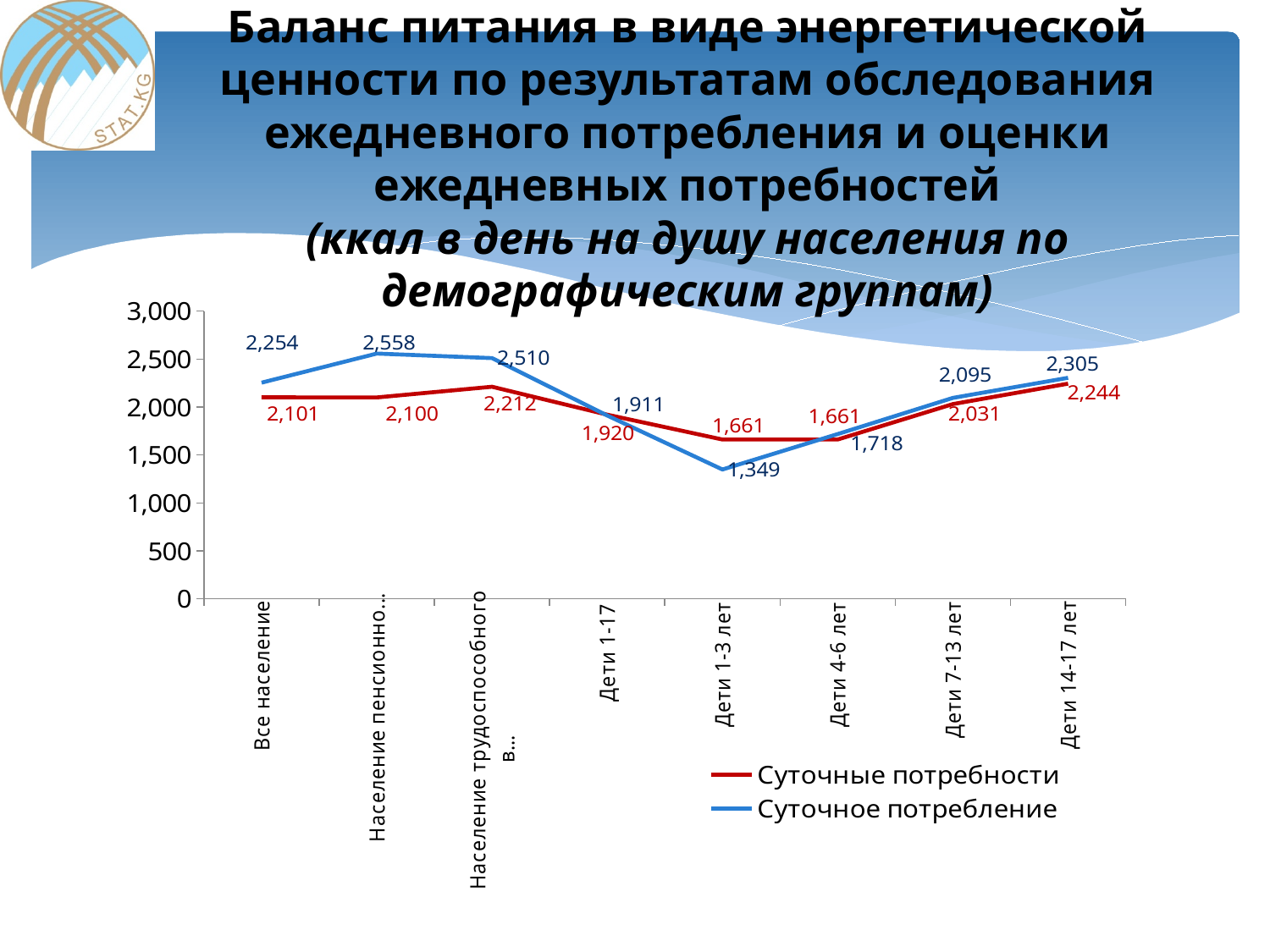
What is the difference between Суточное потребление and Суточные потребности for Дети 4-6 лет? 57 Which category has the lowest value for Суточное потребление? Дети 1-3 лет For Дети 7-13 лет, which is larger: Суточные потребности or Суточное потребление? Суточное потребление How many categories are shown on the x axis of the chart? 8 What is the difference between Суточные потребности and Суточное потребление for Дети 1-3 лет? 312 What kind of chart is shown on the slide? line chart How many series does the legend list? 2 What is the value of Суточное потребление for Дети 1-3 лет? 1,349 What is the value of Суточное потребление for Все население? 2,254 Is the value of Суточное потребление for Дети 1-3 лет greater or less than 1,500? less Which category has the highest value for Суточные потребности? Дети 14-17 лет What is the value of Суточные потребности for Дети 14-17 лет? 2,244